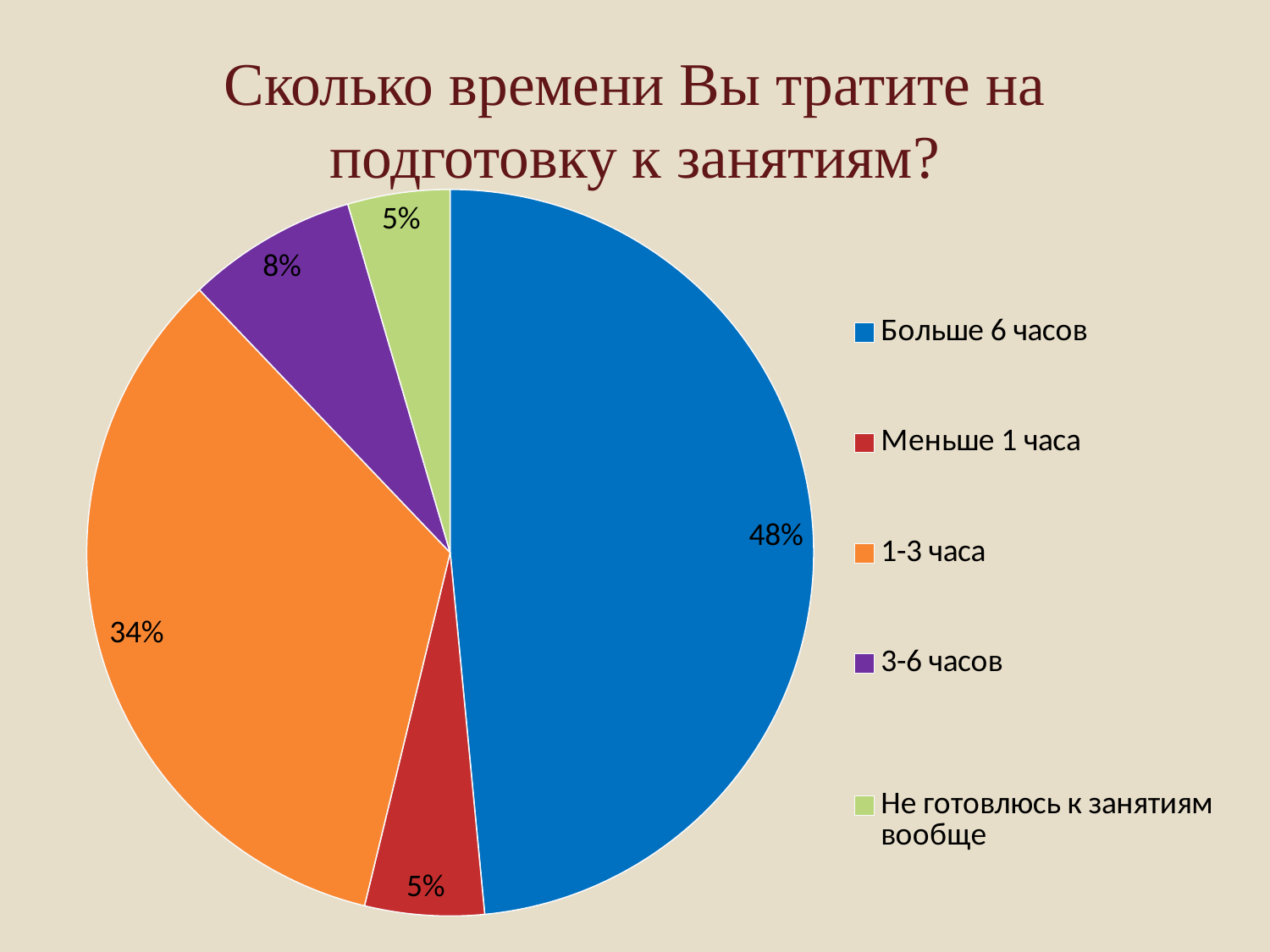
Which is larger, the slice for "3-6 часов" or the slice for "Меньше 1 часа"? 3-6 часов How many categories does the pie chart have? 5 What share of the pie does "Больше 6 часов" take? 48% What is the difference in percentage points between "Больше 6 часов" and "1-3 часа"? 14 What share of the pie does "1-3 часа" take? 34% What is the title of the chart? Сколько времени Вы тратите на подготовку к занятиям? What colour is the slice for "1-3 часа"? orange Which category has the largest slice of the pie? Больше 6 часов What type of chart is shown on the slide? pie chart What share of the pie does "Меньше 1 часа" take? 5%